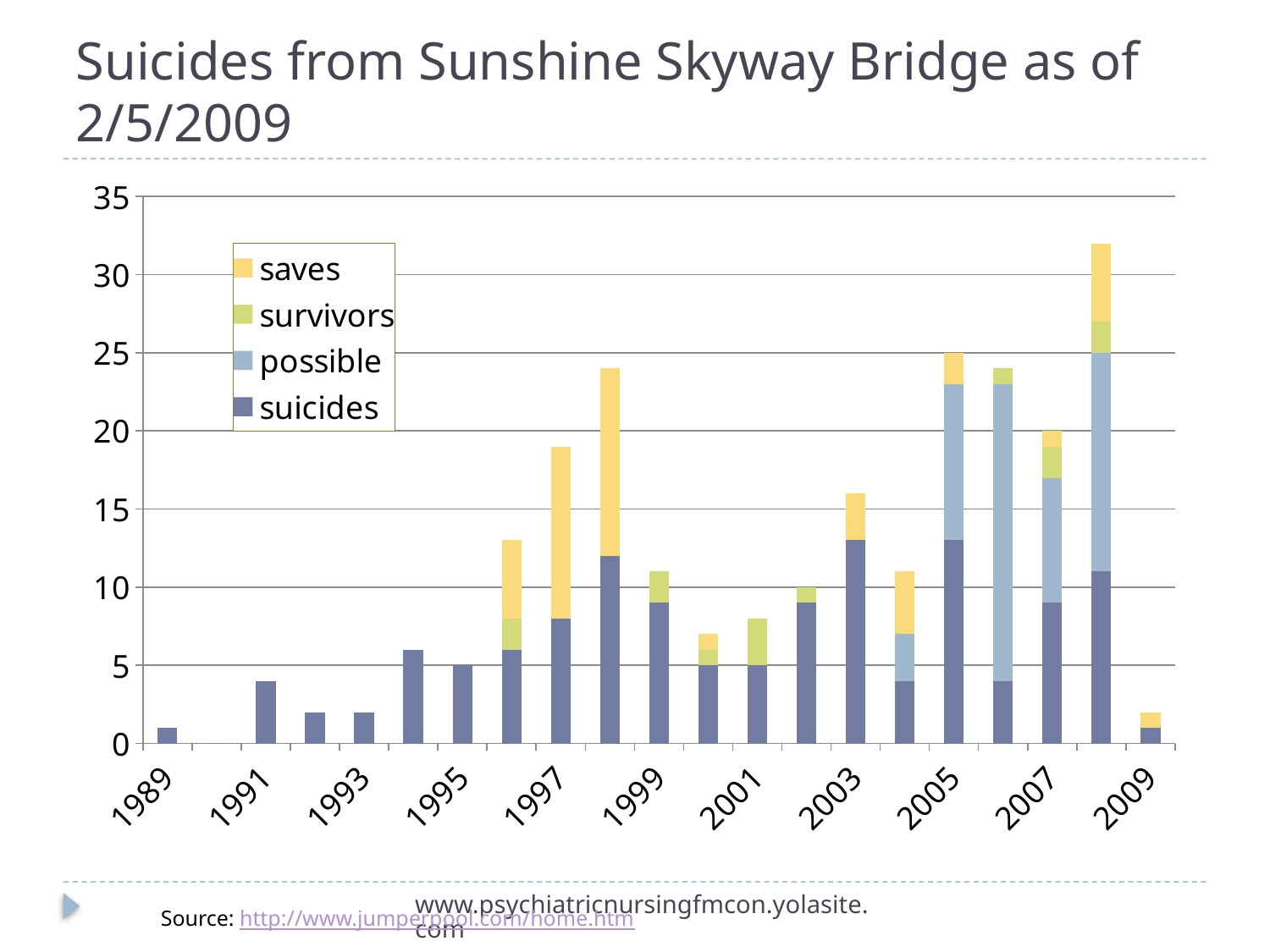
Is the total for 2009 greater or less than 5? less What is the total height of the stacked bar for 2005? 25 How many series does the legend list? 4 Is the total for 1991 greater or less than 5? less What is the value of the bar for 1995? 5 What is the total height of the stacked bar for 2007? 20 Which series is shown in yellow in the legend? saves Is the total for 1997 greater or less than 15? greater What is the title of the chart? Suicides from Sunshine Skyway Bridge as of 2/5/2009 Which year has the taller stacked bar, 2003 or 2005? 2005 What kind of chart is shown on the slide? stacked bar chart Which year has the taller stacked bar, 1997 or 1999? 1997